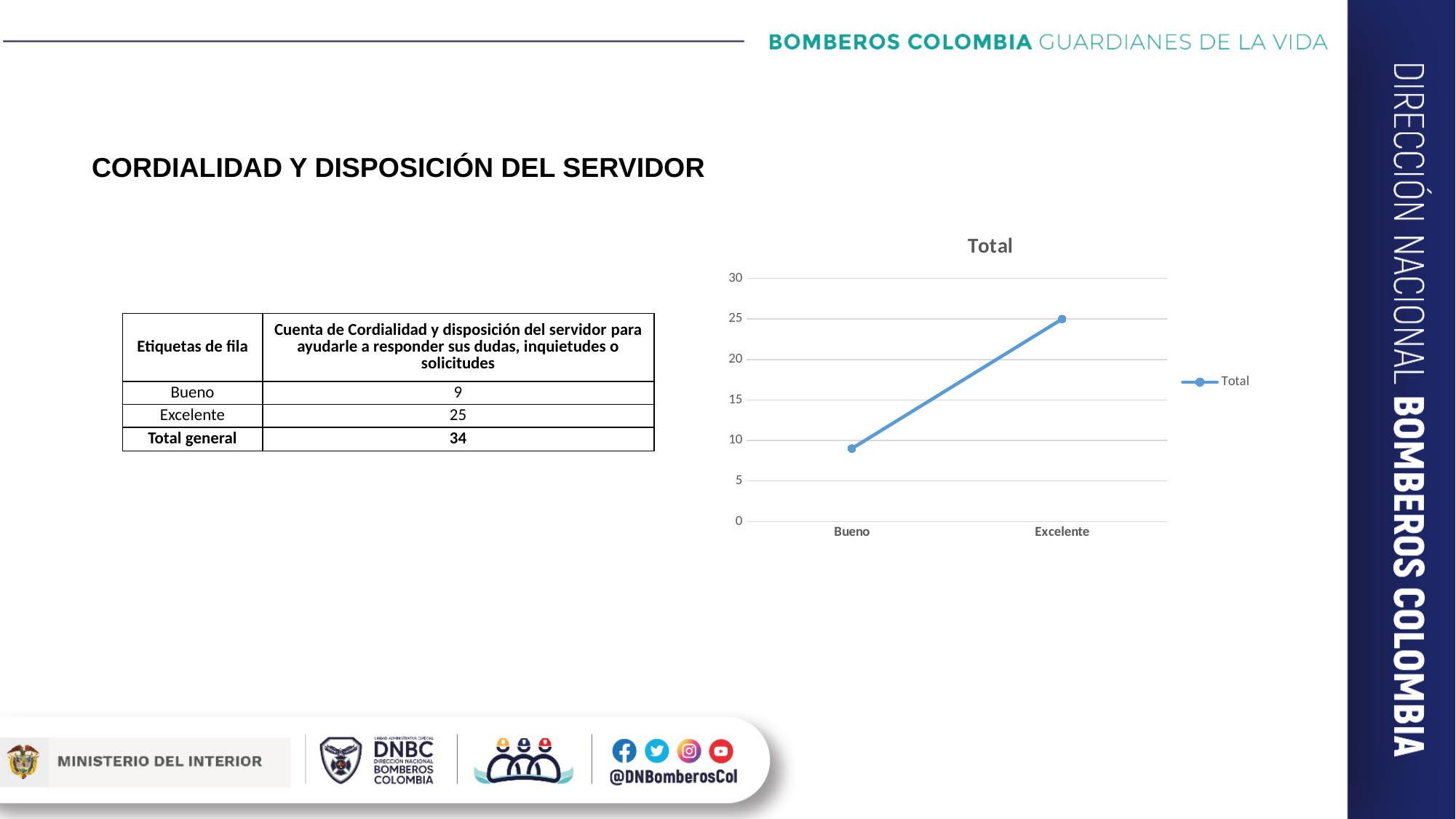
What is the value for Excelente in the chart? 25 Which category has the lowest value in the chart? Bueno What is the value for Bueno in the chart? 9 What is the difference between the values for Excelente and Bueno? 16 How many series does the chart legend list? 1 Which is larger, the value for Bueno or the value for Excelente? Excelente How many categories are plotted on the x axis of the chart? 2 Is the value for Bueno greater or less than 10? less What series name appears in the chart legend? Total Which category has the highest value in the chart? Excelente What kind of chart is shown on the slide? line chart What is the title of the chart? Total